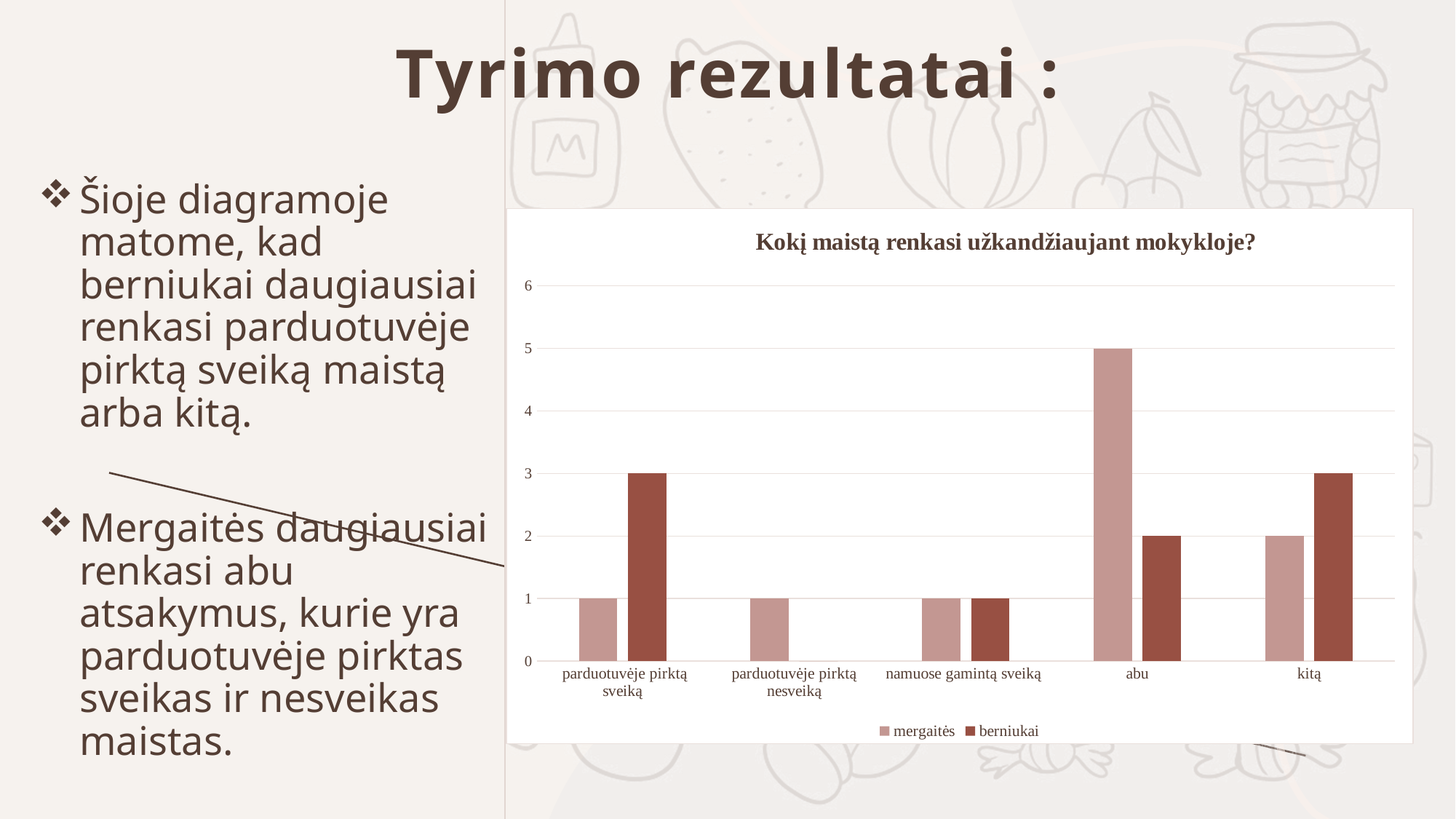
What is the title of the chart? Kokį maistą renkasi užkandžiaujant mokykloje? How many series does the legend list? 2 In the category kitą, which series has the larger value, mergaitės or berniukai? berniukai What is the value for berniukai in the category parduotuvėje pirktą sveiką? 3 Which category has the highest value for mergaitės? abu What is the difference between the mergaitės and berniukai values in the category abu? 3 What is the value for berniukai in the category kitą? 3 What is the value for mergaitės in the category abu? 5 What kind of chart is shown on the slide? bar chart Is the value for mergaitės in the category abu greater or less than 4? greater Which category has the lowest value for berniukai? parduotuvėje pirktą nesveiką How many categories are shown on the x axis? 5